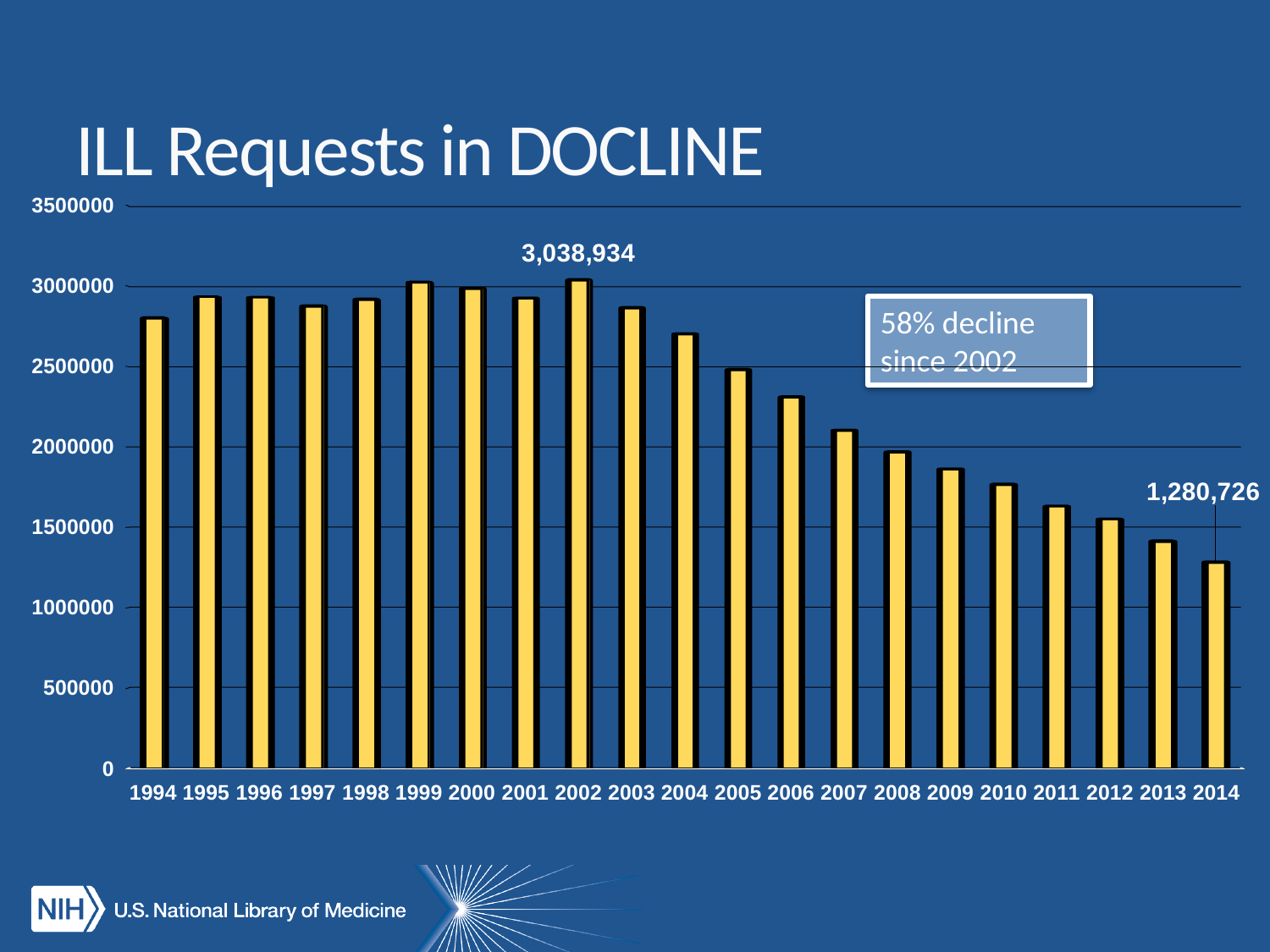
What is the value for 2002? 3,038,934 What kind of chart is this? bar chart Which is larger, the value for 2005 or the value for 2010? 2005 Which year has the lowest number of ILL requests? 2014 What is the value for 2014? 1,280,726 How many years are shown on the x axis? 21 Do the values rise or fall from 2002 to 2014? fall Is the value for 2009 greater or less than 2000000? less Is the value for 2004 greater or less than 2500000? greater What does the annotation box on the chart say? 58% decline since 2002 What is the difference between the 2002 value and the 2014 value? 1,758,208 Is the value for 2006 greater or less than 2500000? less